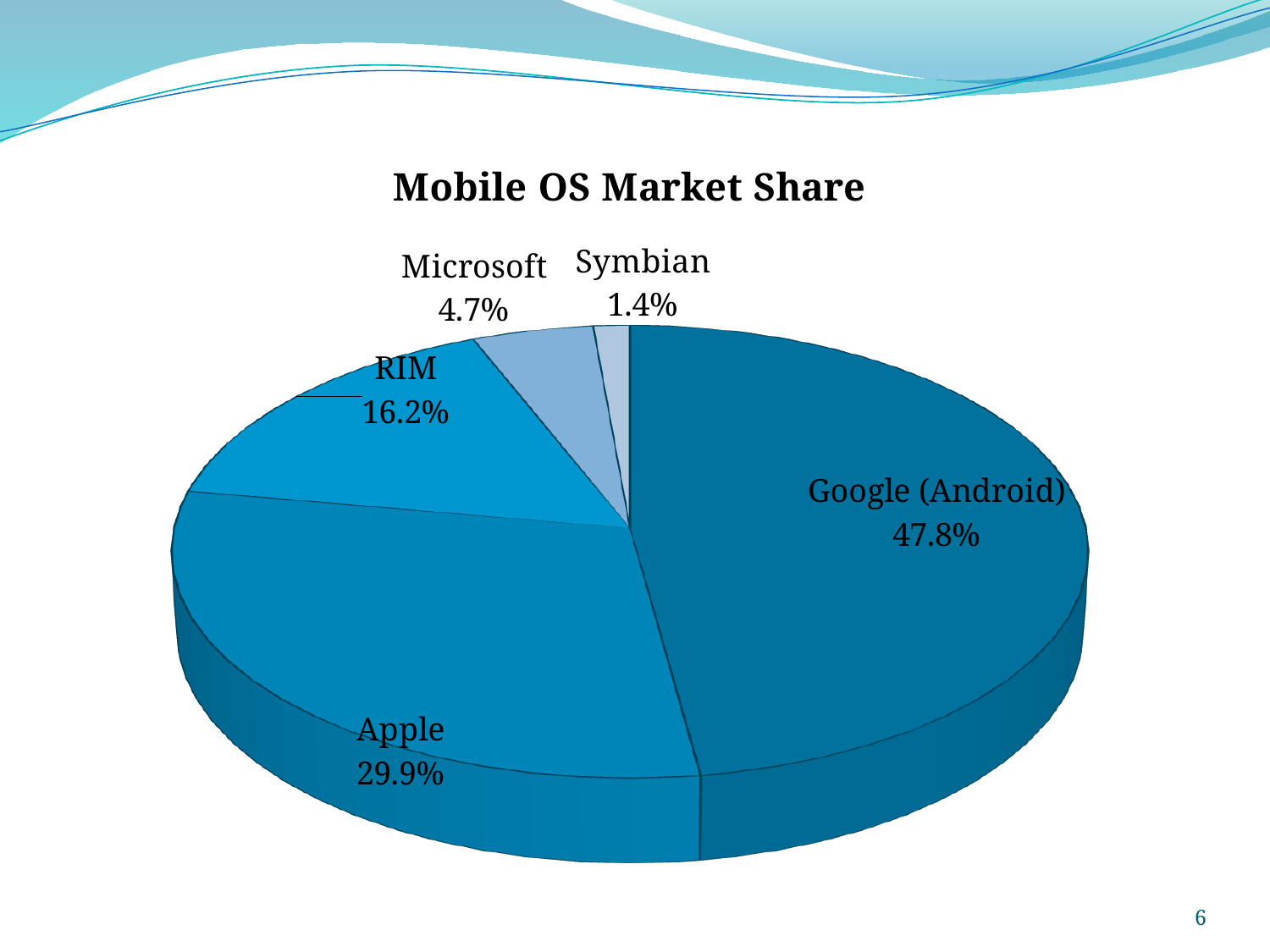
How many mobile OS categories are shown in the pie chart? 5 What is the difference in market share between Google (Android) and Apple? 17.9% Which mobile OS has the smallest market share? Symbian What is the market share of Google (Android)? 47.8% What is the title of the chart? Mobile OS Market Share Which has a larger market share, RIM or Microsoft? RIM What is the market share of Apple? 29.9% What is the market share of Microsoft? 4.7% What is the market share of RIM? 16.2% What is the market share of Symbian? 1.4% What kind of chart is shown on the slide? Pie chart Which mobile OS has the largest market share? Google (Android)